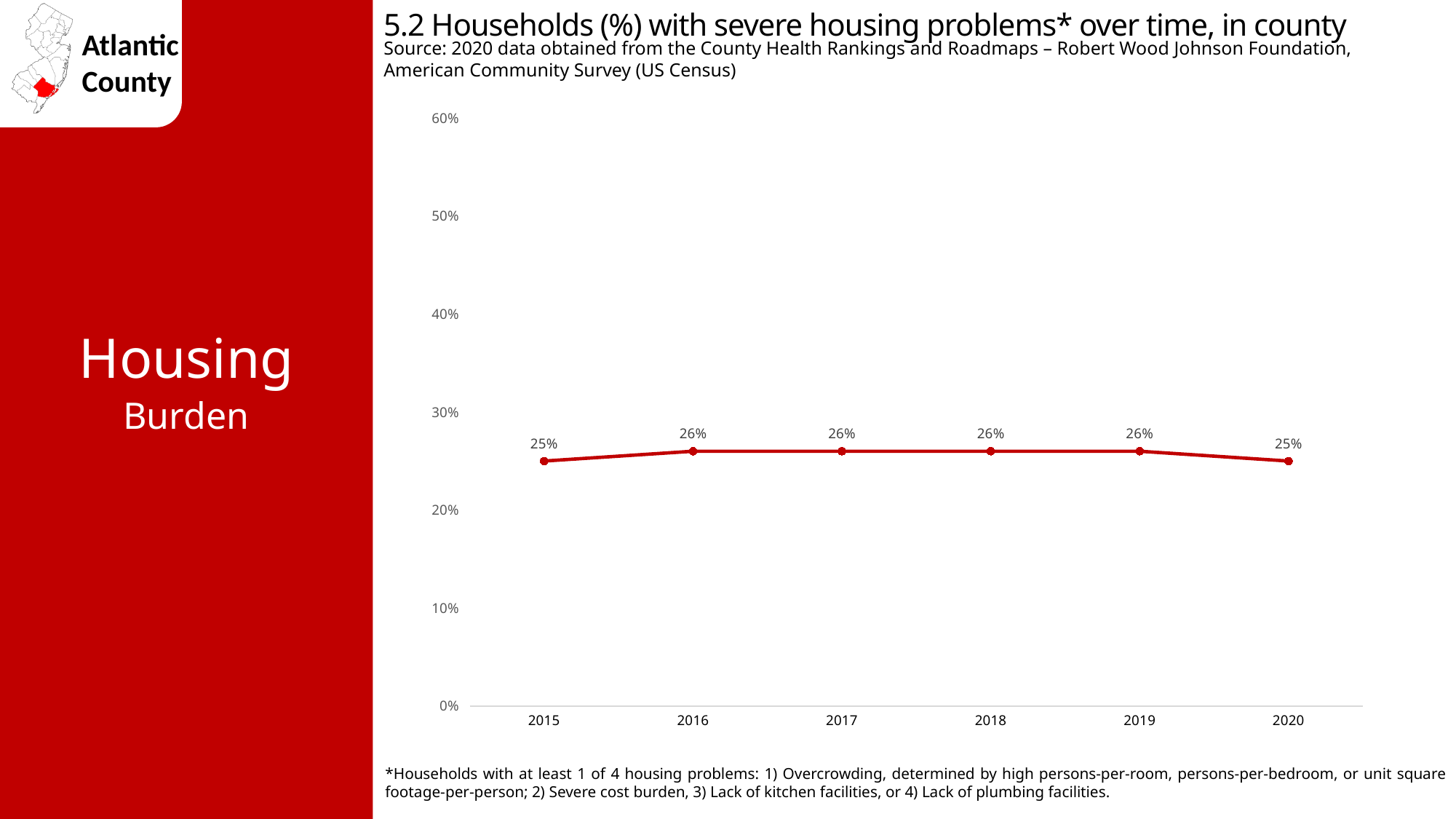
What percentage of households had severe housing problems in 2020? 25% What is the difference between the 2016 value and the 2015 value? 1% What is the highest value shown on the y axis? 60% Is the value for 2019 greater or less than 30%? less Which is larger, the value for 2016 or the value for 2020? 2016 What is the value shown for 2018? 26% Is the value for 2017 greater or less than 20%? greater What is the value shown for 2017? 26% How many years are plotted on the x axis? 6 What is the title of the chart? 5.2 Households (%) with severe housing problems* over time, in county What percentage of households had severe housing problems in 2015? 25% What kind of chart is shown on the slide? line chart